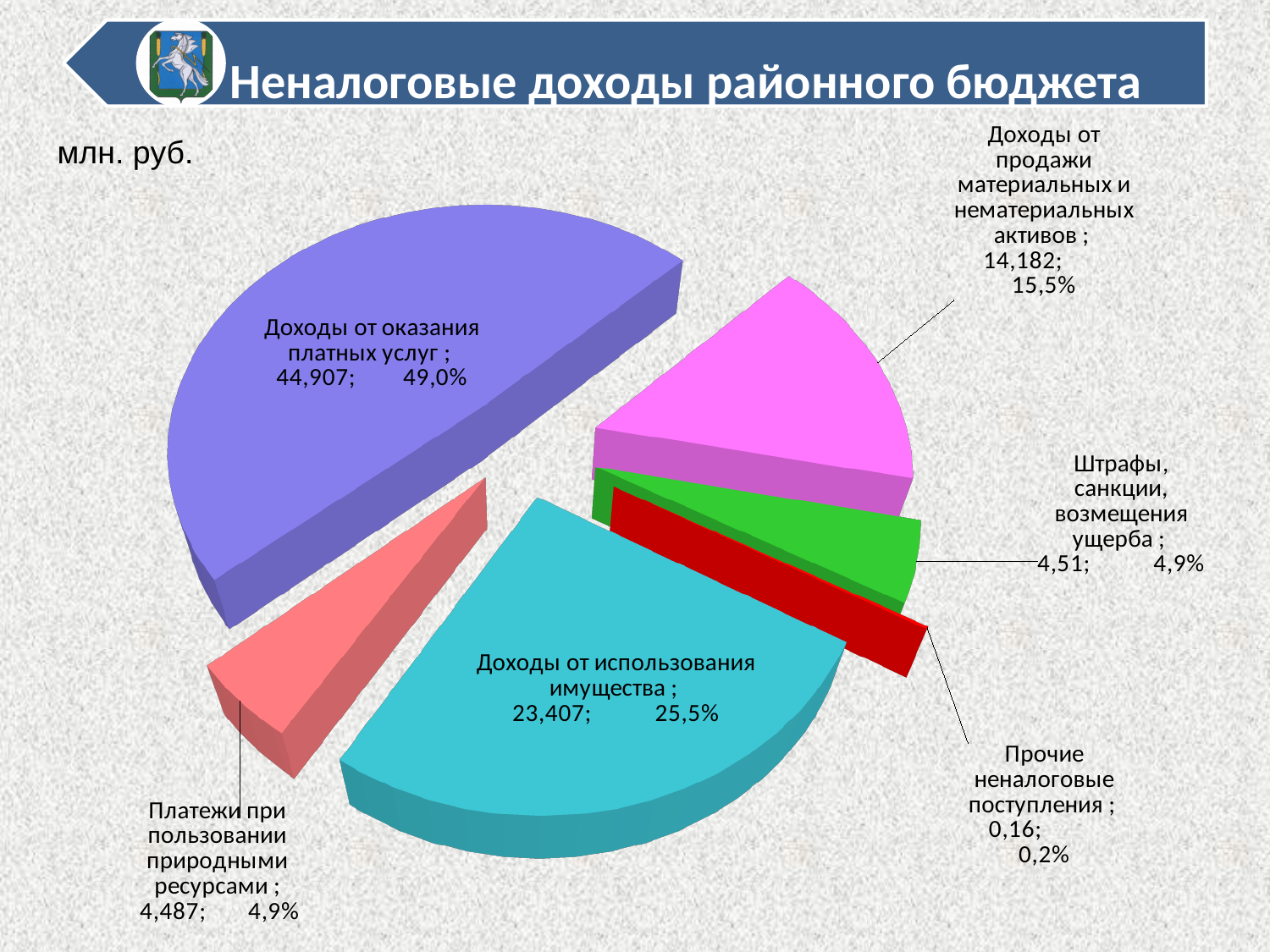
Which category has the largest slice? Доходы от оказания платных услуг What is the value for «Прочие неналоговые поступления»? 0,16 What is the value for «Доходы от оказания платных услуг»? 44,907 What share of the pie does «Доходы от использования имущества» represent? 25,5% What is the value for «Доходы от продажи материальных и нематериальных активов»? 14,182 What share of the pie does «Платежи при пользовании природными ресурсами» represent? 4,9% How many slices does the pie chart have? 6 What is the difference between «Доходы от использования имущества» and «Доходы от продажи материальных и нематериальных активов»? 9,225 What is the value for «Доходы от использования имущества»? 23,407 Which is larger: «Доходы от продажи материальных и нематериальных активов» or «Штрафы, санкции, возмещения ущерба»? Доходы от продажи материальных и нематериальных активов Which category has the smallest slice? Прочие неналоговые поступления What kind of chart is shown on the slide? pie chart